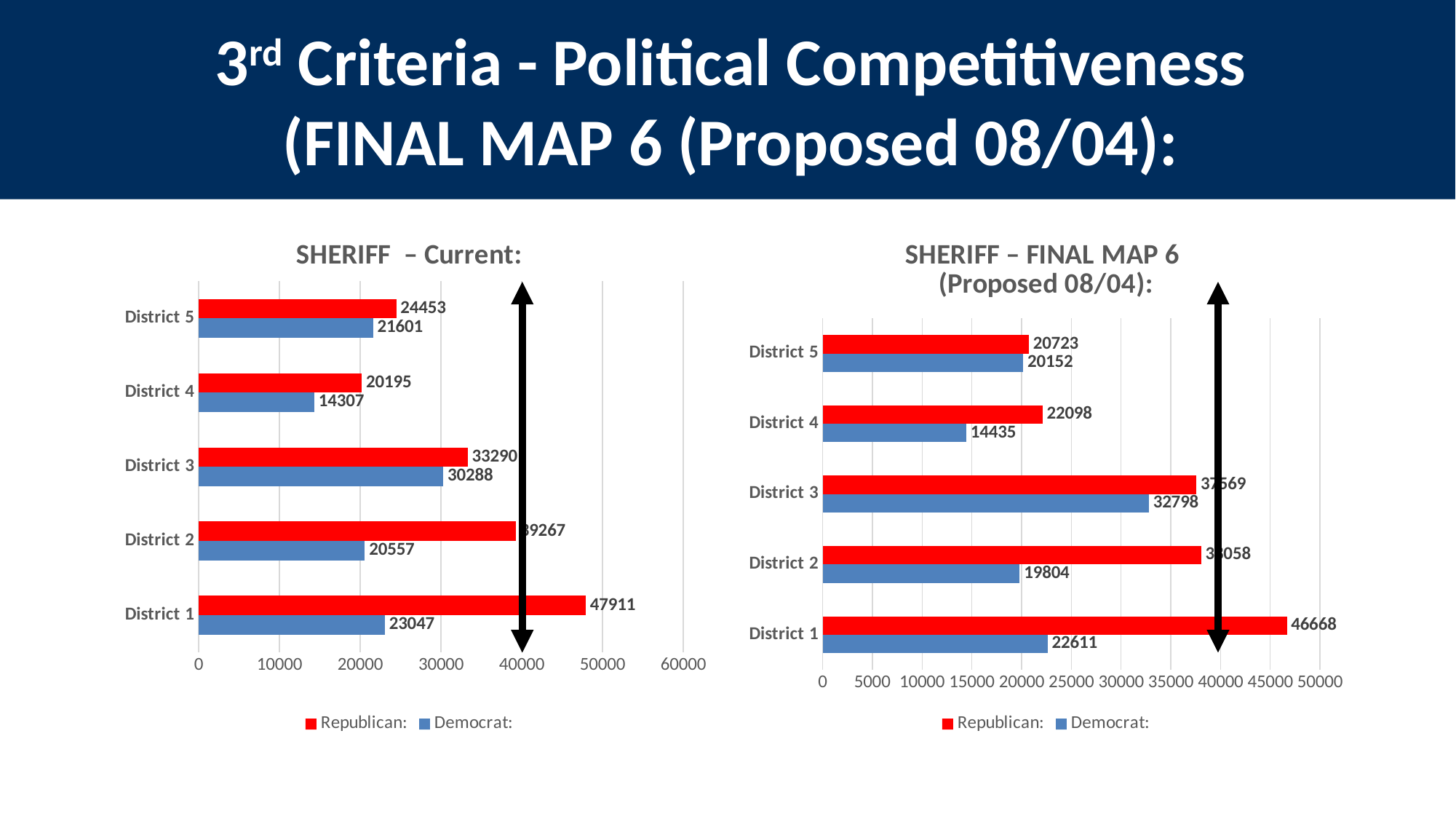
How many series does the legend of the SHERIFF – Current chart list? 2 In the SHERIFF – FINAL MAP 6 (Proposed 08/04) chart, what is the difference between the Republican and Democrat values for District 5? 571 In the SHERIFF – FINAL MAP 6 (Proposed 08/04) chart, which district has the lowest Democrat value? District 4 In the SHERIFF – FINAL MAP 6 (Proposed 08/04) chart, what is the Democrat value for District 3? 32798 In the SHERIFF – FINAL MAP 6 (Proposed 08/04) chart, what is the Republican value for District 5? 20723 In the SHERIFF – Current chart, what is the Democrat value for District 4? 14307 In the SHERIFF – Current chart, what is the Republican value for District 1? 47911 How many districts are shown in the SHERIFF – FINAL MAP 6 (Proposed 08/04) chart? 5 What type of chart is the SHERIFF – Current chart? Bar chart In the SHERIFF – Current chart, is the Democrat value for District 3 larger than the Democrat value for District 5? Yes In the SHERIFF – Current chart, which district has the highest Republican value? District 1 In the SHERIFF – Current chart, what is the difference between the Republican and Democrat values for District 1? 24864